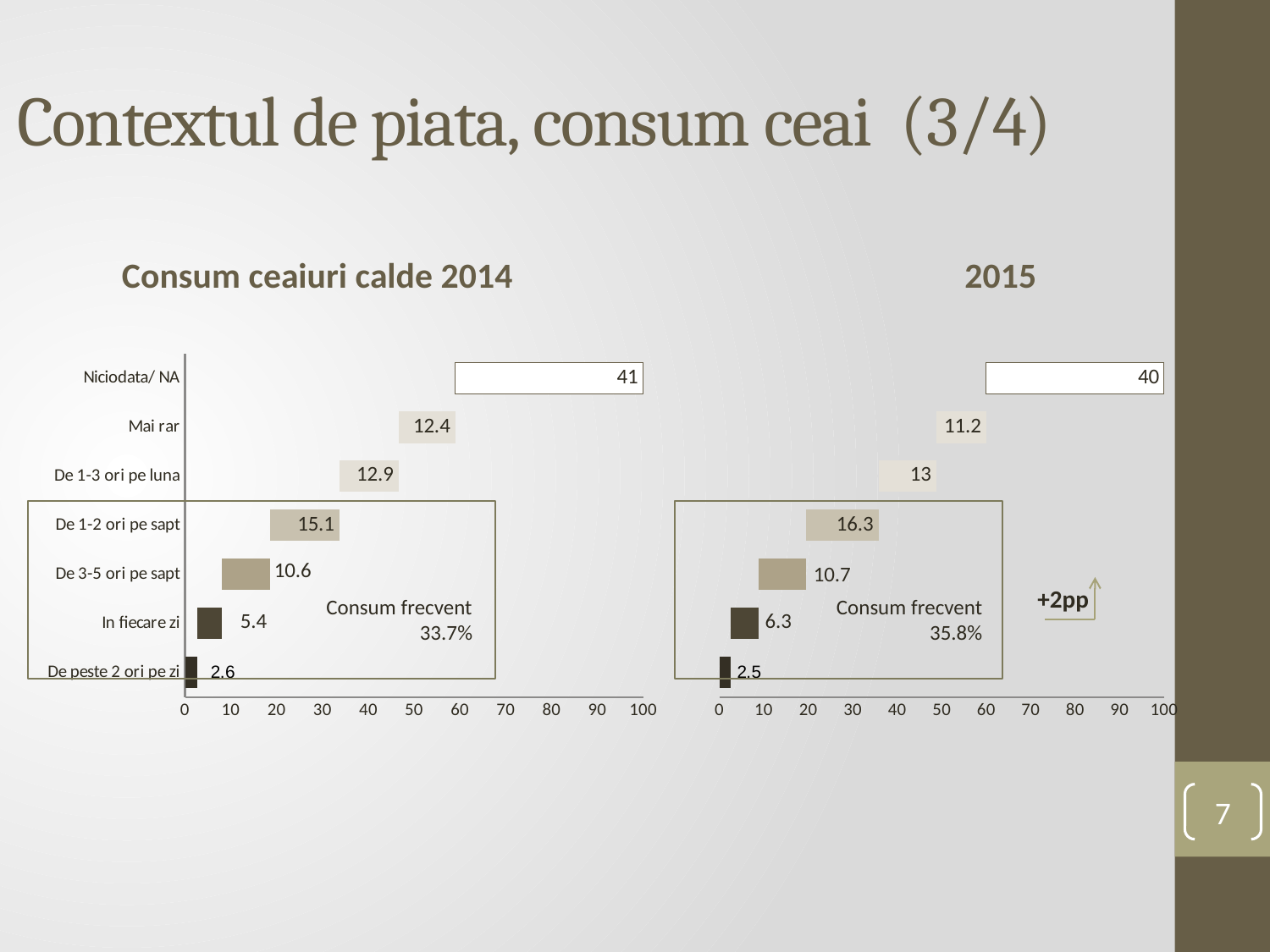
What type of chart is the 'Consum ceaiuri calde 2014' chart? Bar chart In the 'Consum ceaiuri calde 2014' chart, what is the value for 'Niciodata/ NA'? 41 In the 2015 chart, what is the value shown for the 'De 1-2 ori pe sapt' row? 16.3 In the 'Consum ceaiuri calde 2014' chart, which category has the highest value? Niciodata/ NA In the 2015 chart, what is the value shown for the 'Niciodata/ NA' row? 40 In the 'Consum ceaiuri calde 2014' chart, what is the value for 'In fiecare zi'? 5.4 In the 'Consum ceaiuri calde 2014' chart, what is the difference between 'De 1-2 ori pe sapt' and 'De 3-5 ori pe sapt'? 4.5 What 'Consum frecvent' percentage is shown in the 2015 chart? 35.8% In the 'Consum ceaiuri calde 2014' chart, which is larger: 'Mai rar' or 'De 1-3 ori pe luna'? De 1-3 ori pe luna In the 'Consum ceaiuri calde 2014' chart, what is the value for 'De 1-2 ori pe sapt'? 15.1 How many categories are shown in the 'Consum ceaiuri calde 2014' chart? 7 In the 'Consum ceaiuri calde 2014' chart, which category has the lowest value? De peste 2 ori pe zi